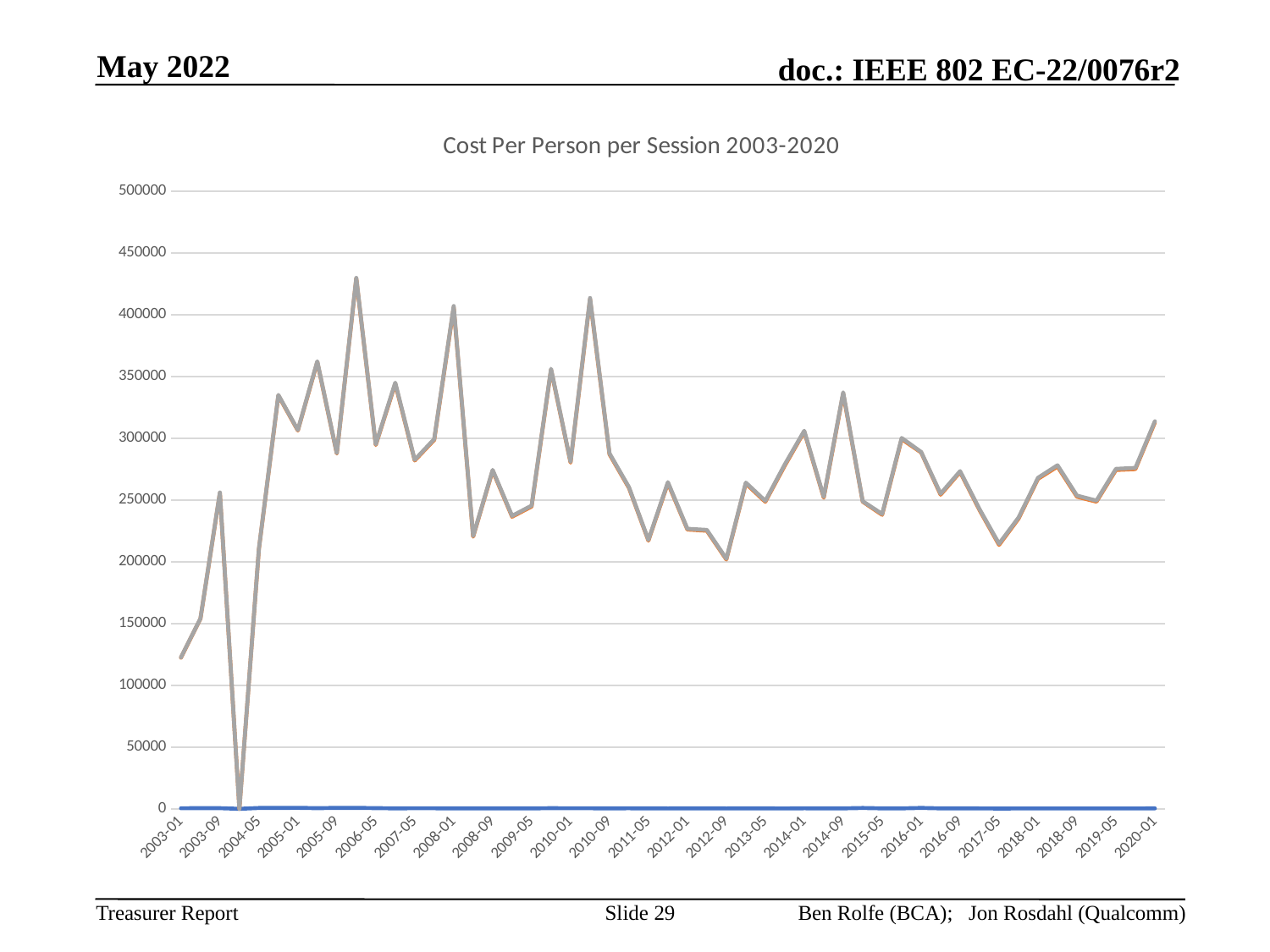
Is the value for 2003-09 greater or less than 200000? greater What is the title of the chart? Cost Per Person per Session 2003-2020 Is the value for 2003-01 greater or less than 150000? less Is the value for 2014-09 greater or less than 300000? greater Does the value rise or fall from 2003-01 to 2003-09? rise Which is larger, the value for 2003-01 or the value for 2020-01? 2020-01 What kind of chart is shown on the slide? line chart